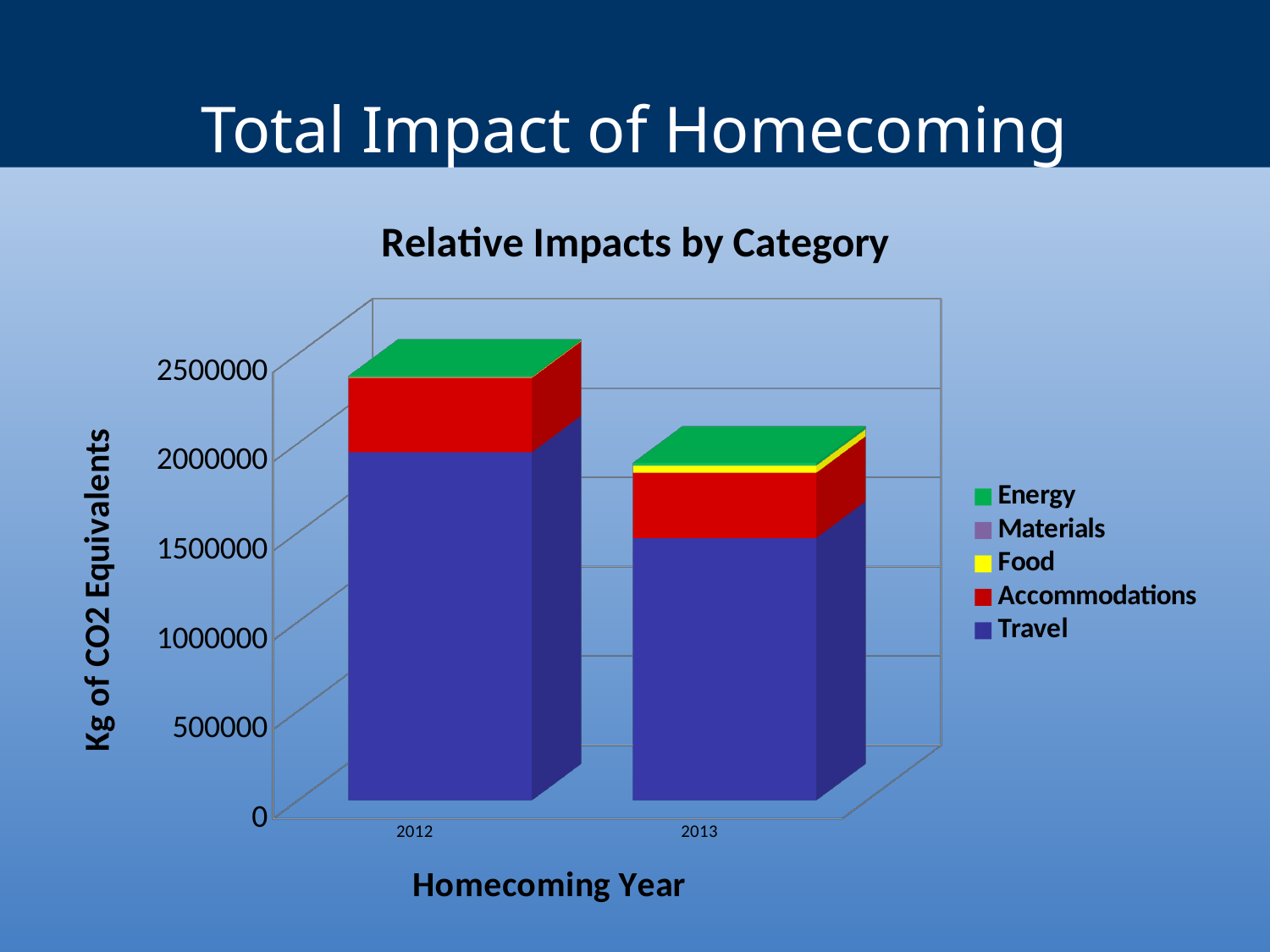
Which series makes up the largest portion of each bar? Travel Is the Travel value for 2013 greater or less than 1000000? greater Which year has the higher total Kg of CO2 Equivalents? 2012 Which year has the lower total Kg of CO2 Equivalents? 2013 How many homecoming years are plotted on the x axis? 2 How many series does the legend list? 5 Is the total value for 2013 greater or less than 1500000? greater Do the total impacts rise or fall from 2012 to 2013? Fall What type of chart is shown on the slide? Stacked bar chart Is the total for 2012 larger or smaller than the total for 2013? Larger What is the title of the chart? Relative Impacts by Category Is the total value for 2012 greater or less than 2000000? greater